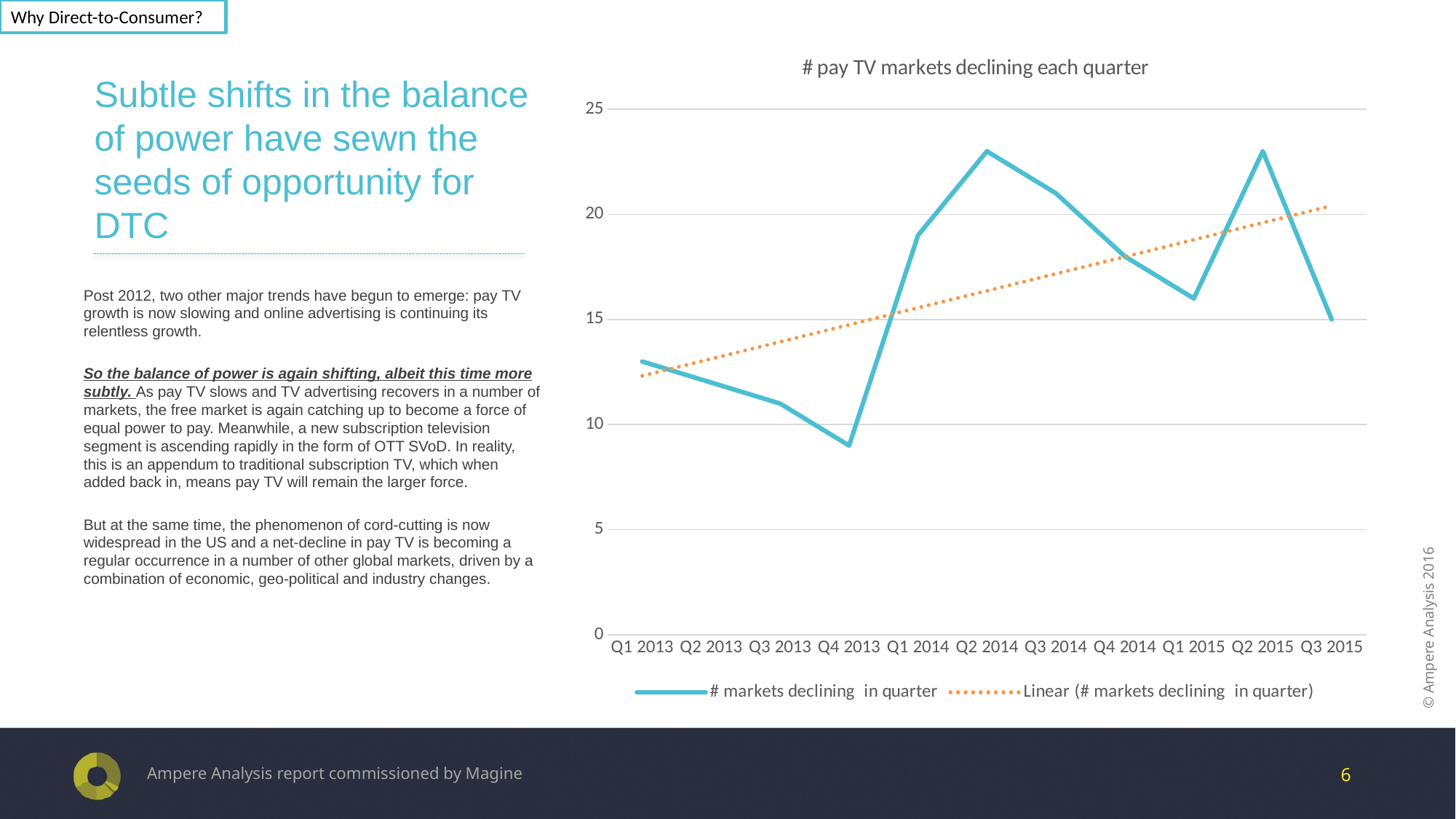
What kind of chart is shown on the slide? line chart How many quarters are plotted along the x axis of the chart? 11 Is the value for Q1 2013 greater or less than 15? less Which is larger, the value for Q1 2013 or the value for Q1 2014? Q1 2014 Is the value for Q1 2015 greater or less than 15? greater Which quarter has the lowest number of pay TV markets declining? Q4 2013 Does the dotted linear trend line rise or fall across the chart? rise Is the value for Q2 2014 greater or less than 20? greater Do the values rise or fall from Q1 2013 to Q4 2013? fall How many series does the chart legend list? 2 What is the title of the chart? # pay TV markets declining each quarter